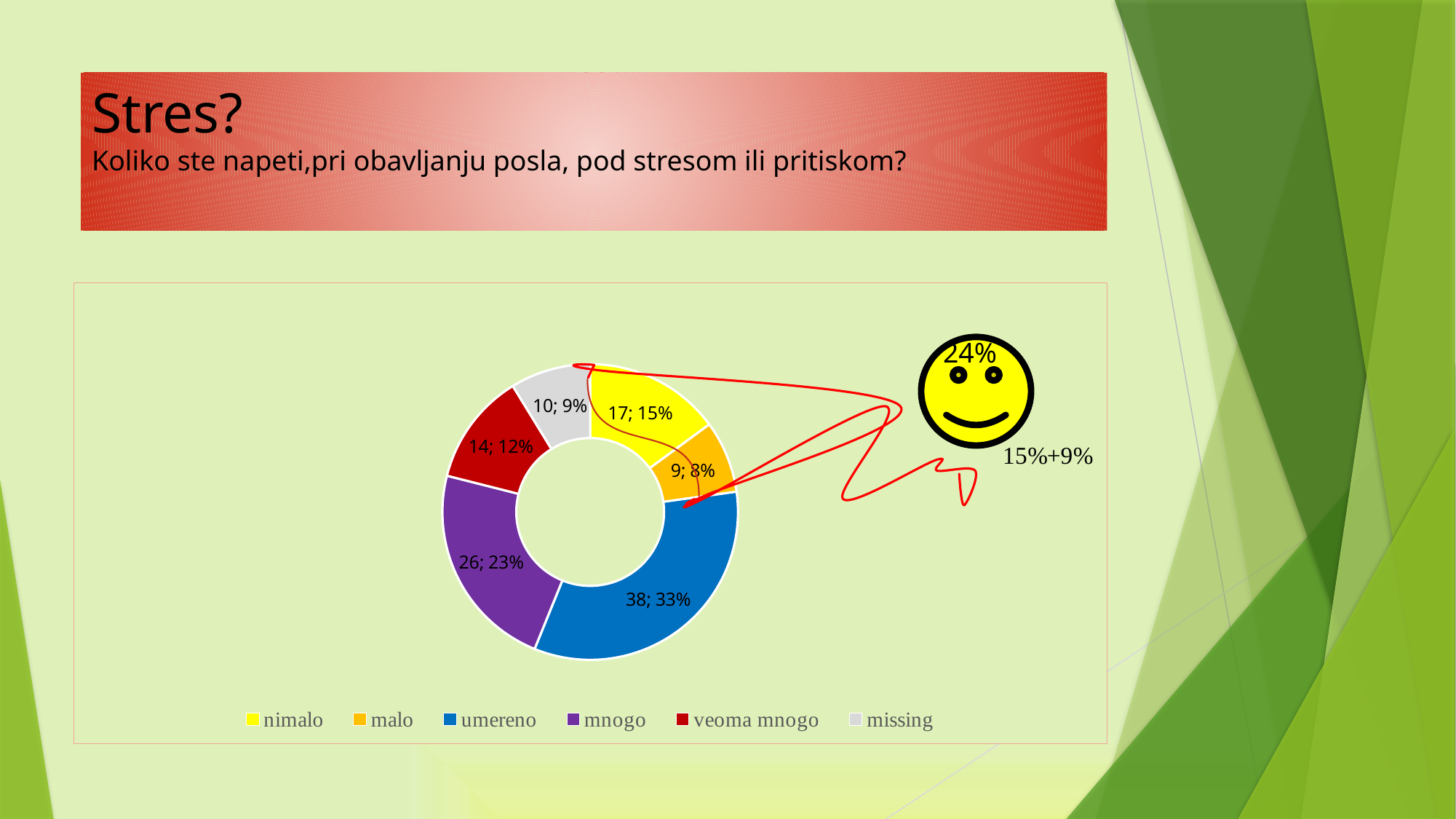
What percentage share does the 'malo' slice have? 8% What is the count shown for the 'nimalo' slice? 17 How many categories does the legend of the chart list? 6 What percentage share does the 'missing' slice have? 9% What kind of chart is shown on the slide? doughnut chart What percentage share does the 'mnogo' slice have? 23% What colour is the 'veoma mnogo' slice? red What is the count shown for the 'umereno' slice? 38 Which is larger, the 'veoma mnogo' slice or the 'missing' slice? veoma mnogo What is the difference in count between 'umereno' and 'mnogo'? 12 Which category has the largest slice? umereno Which category has the smallest slice? malo